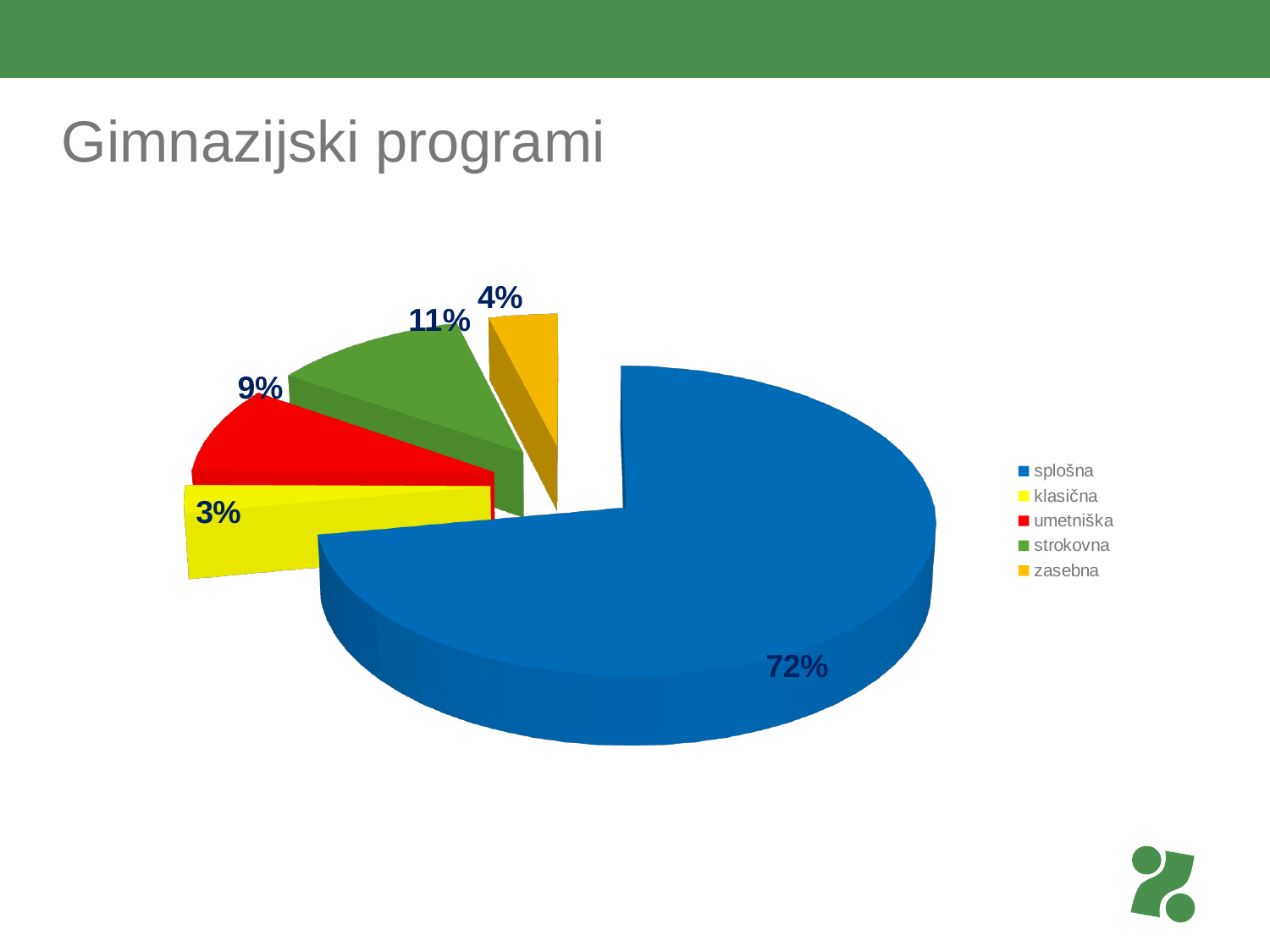
How many categories does the pie chart have? 5 What is the title of the slide containing the chart? Gimnazijski programi What is the difference in percentage points between strokovna and umetniška? 2% What share of the pie does splošna have? 72% What kind of chart is shown on the slide? pie chart Which category has the smallest slice of the pie? klasična What share of the pie does strokovna have? 11% What share of the pie does umetniška have? 9% Which category has the largest slice of the pie? splošna Which is larger, the share for umetniška or the share for zasebna? umetniška